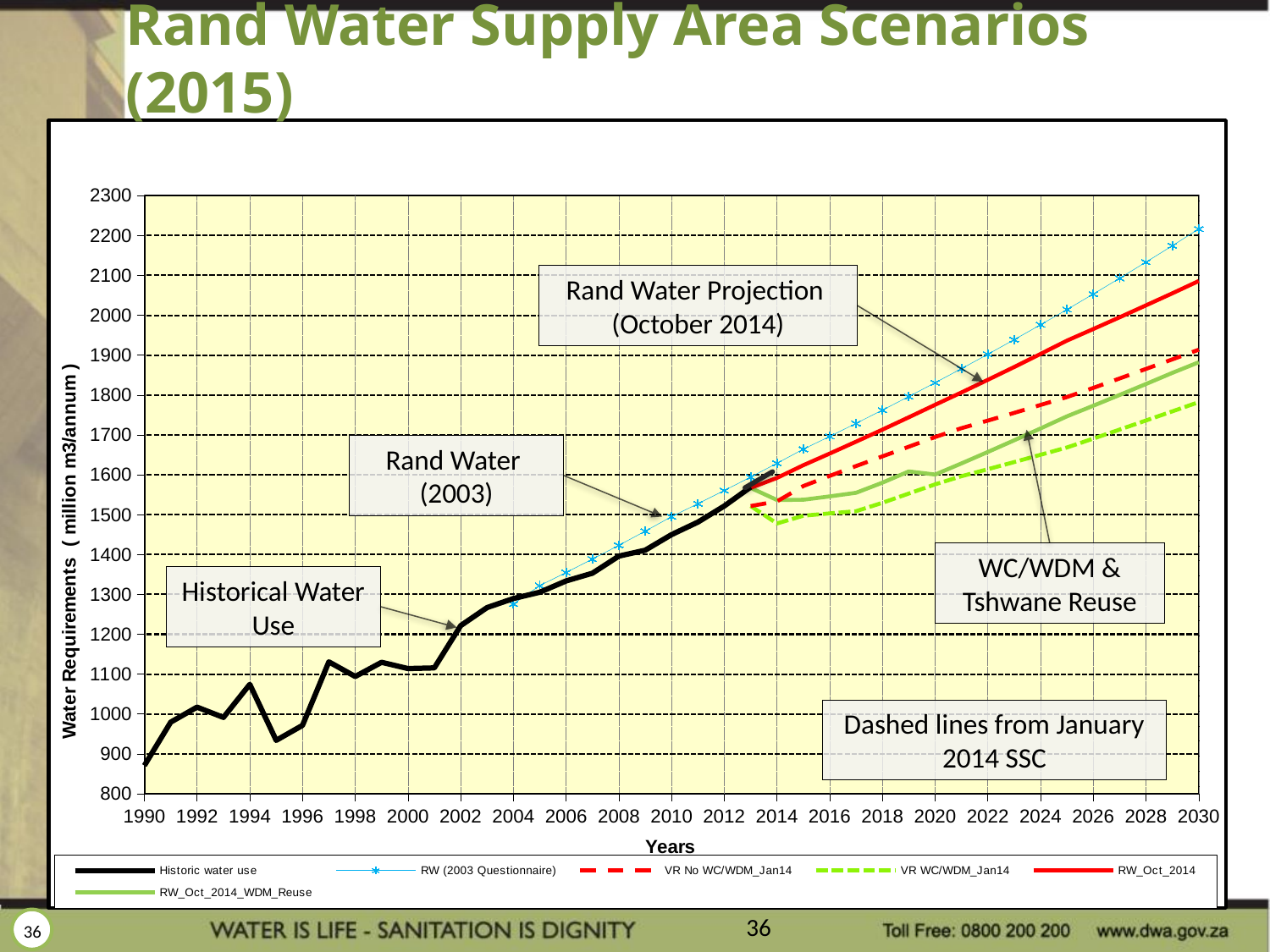
How many series does the chart legend list? 6 Which series has the highest value in 2030? RW (2003 Questionnaire) In 2030, which is larger: VR No WC/WDM_Jan14 or VR WC/WDM_Jan14? VR No WC/WDM_Jan14 What is the label on the vertical axis of the chart? Water Requirements (million m3/annum) Is the Historic water use value in 1995 greater or less than 1000? less Is the RW (2003 Questionnaire) value in 2030 greater or less than 2100? greater Which series has the lowest value in 2030? VR WC/WDM_Jan14 Is the RW_Oct_2014 value in 2030 greater or less than 2000? greater What kind of chart is shown on the slide? line chart What is the title of the slide's chart? Rand Water Supply Area Scenarios (2015)